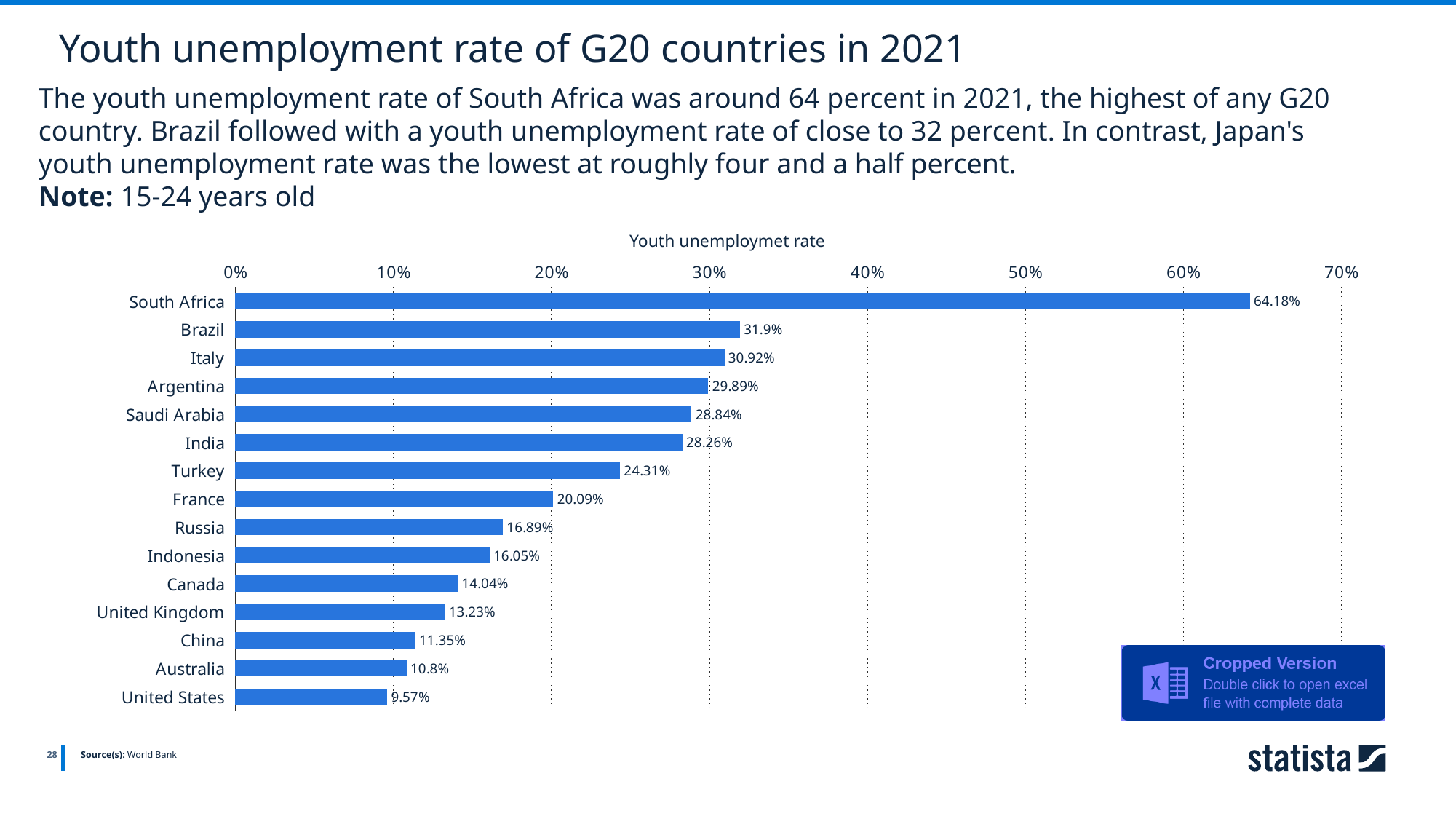
What is the difference in percentage points between the youth unemployment rates of Turkey and France? 4.22 percentage points What is the youth unemployment rate shown for South Africa? 64.18% Which country has the lowest youth unemployment rate among those plotted in the chart? United States What is the youth unemployment rate shown for the United Kingdom? 13.23% What is the title of the chart? Youth unemploymet rate What is the difference in percentage points between the youth unemployment rates of South Africa and Brazil? 32.28 percentage points How many countries are plotted in the chart? 15 What is the youth unemployment rate shown for Turkey? 24.31% Which has a higher youth unemployment rate, Russia or Indonesia? Russia What type of chart is used on this slide? Bar chart Is the youth unemployment rate for India greater or less than 30%? less Which country has the highest youth unemployment rate in the chart? South Africa